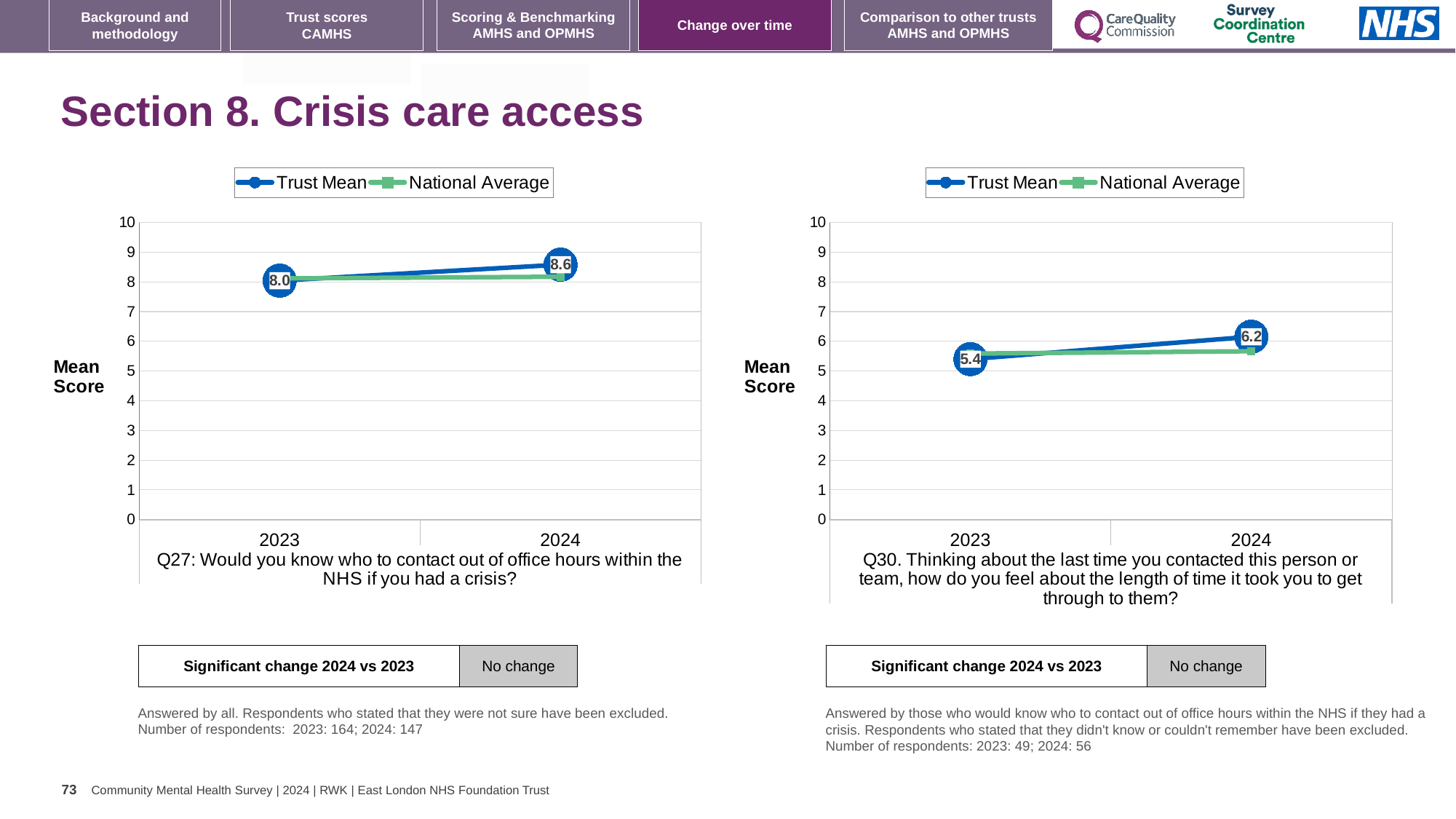
How many series does the legend list in the Q30 chart on the right? 2 In the Q27 chart on the left, what is the Trust Mean score for 2024? 8.6 Which year has the higher Trust Mean in the Q27 chart on the left, 2023 or 2024? 2024 In the Q30 chart on the right, what is the difference between the Trust Mean in 2024 and in 2023? 0.8 In the Q30 chart on the right, is the National Average for 2023 greater or less than 7? less In the Q27 chart on the left, what is the Trust Mean score for 2023? 8.0 In the Q27 chart on the left, by how much did the Trust Mean change from 2023 to 2024? 0.6 In the Q30 chart on the right, what is the Trust Mean score for 2023? 5.4 In the Q30 chart on the right, does the Trust Mean rise or fall from 2023 to 2024? rise In the Q27 chart on the left, is the Trust Mean for 2024 greater or less than 8? greater What type of chart is the Q27 chart on the left? line chart In the Q30 chart on the right, what is the Trust Mean score for 2024? 6.2